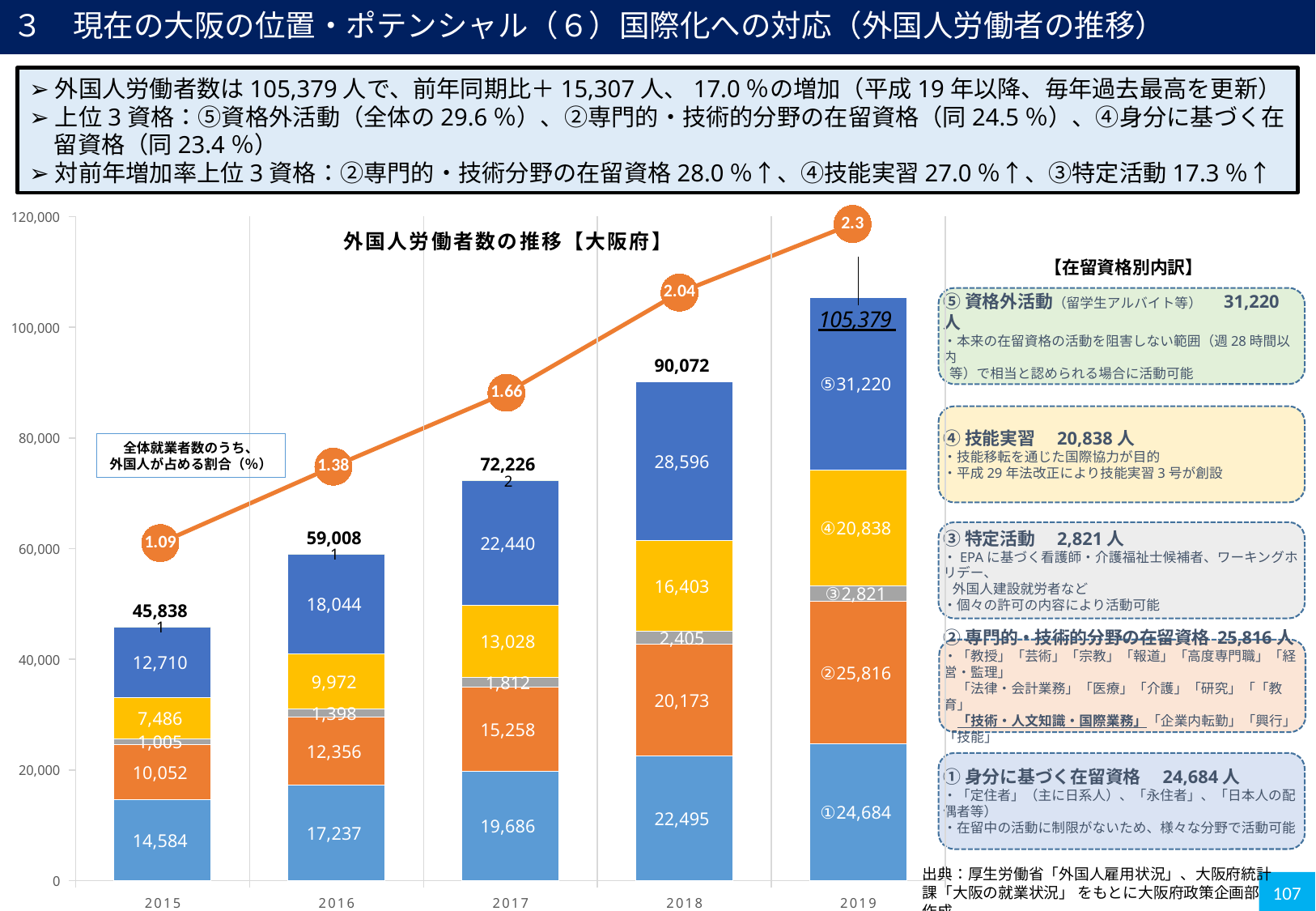
What is the total number of foreign workers shown for 2015? 45,838 Is the total for 2017 greater or less than 80,000? less What is the value of the line (全体就業者数のうち、外国人が占める割合) for 2017? 1.66 Do the total foreign worker numbers rise or fall from 2015 to 2019? rise Which year has the highest total number of foreign workers? 2019 What is the value of the ④技能実習 (yellow) segment in the 2019 bar? 20,838 What is the value of the bottom (①身分に基づく在留資格) segment in the 2018 bar? 22,495 What is the difference between the total for 2019 and the total for 2018? 15,307 How many years are shown on the x axis of the chart? 5 Which year has the lowest total number of foreign workers? 2015 What is the value of the line (全体就業者数のうち、外国人が占める割合) for 2019? 2.3 What is the total number of foreign workers shown for 2019 in the chart 外国人労働者数の推移【大阪府】? 105,379